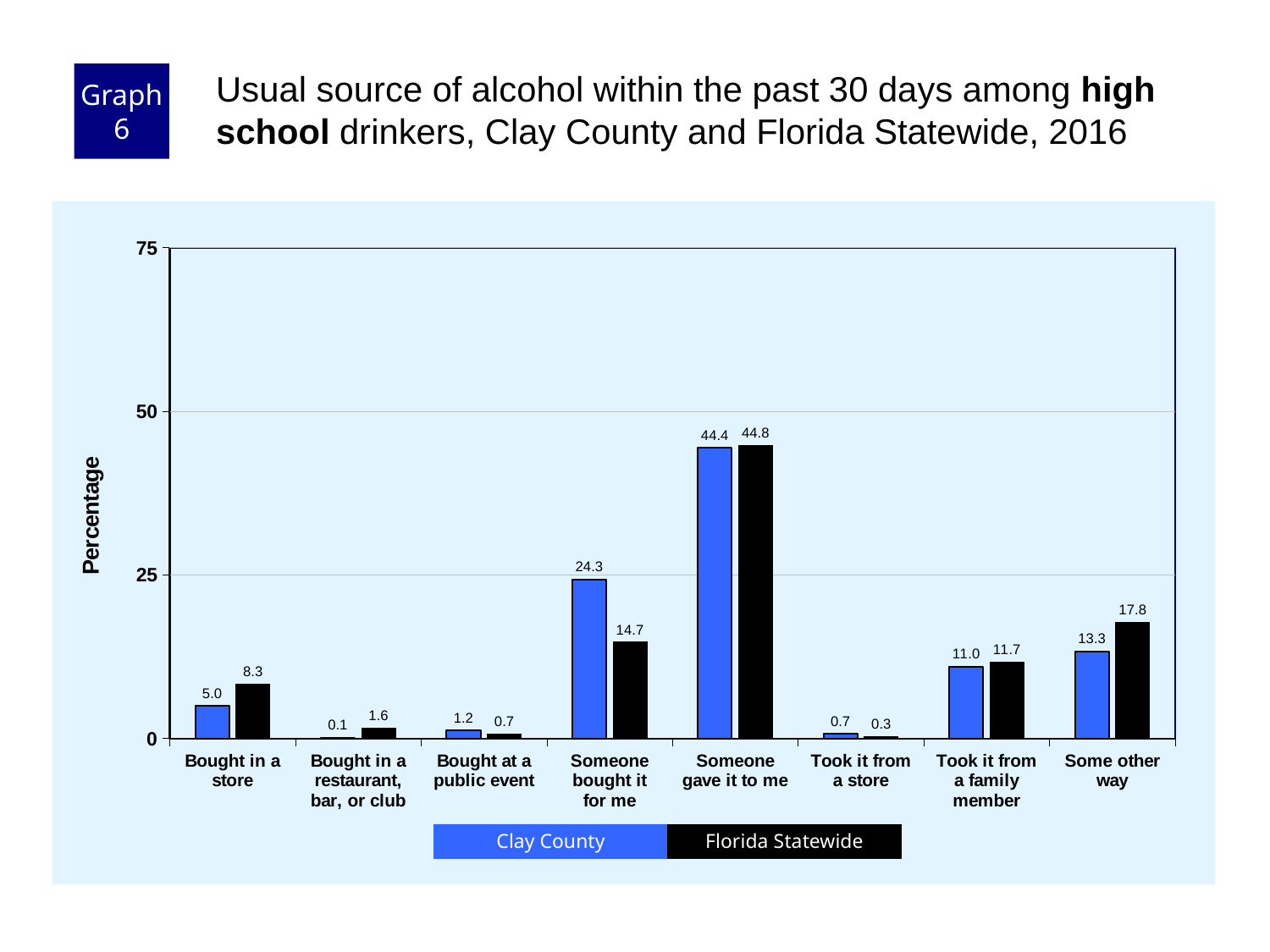
Which category has the lowest Clay County value? Bought in a restaurant, bar, or club What is the Florida Statewide value for "Bought in a store"? 8.3 Is the Florida Statewide value for "Someone gave it to me" greater or less than 25? greater What is the Clay County value for "Someone bought it for me"? 24.3 What is the Florida Statewide value for "Some other way"? 17.8 How many categories are shown on the x axis? 8 How many series does the legend list? 2 What is the difference between the Clay County and Florida Statewide values for "Someone bought it for me"? 9.6 What kind of chart is shown on the slide? Bar chart Which is larger for "Took it from a family member": Clay County or Florida Statewide? Florida Statewide What is the label on the y axis? Percentage Which category has the highest Clay County value? Someone gave it to me